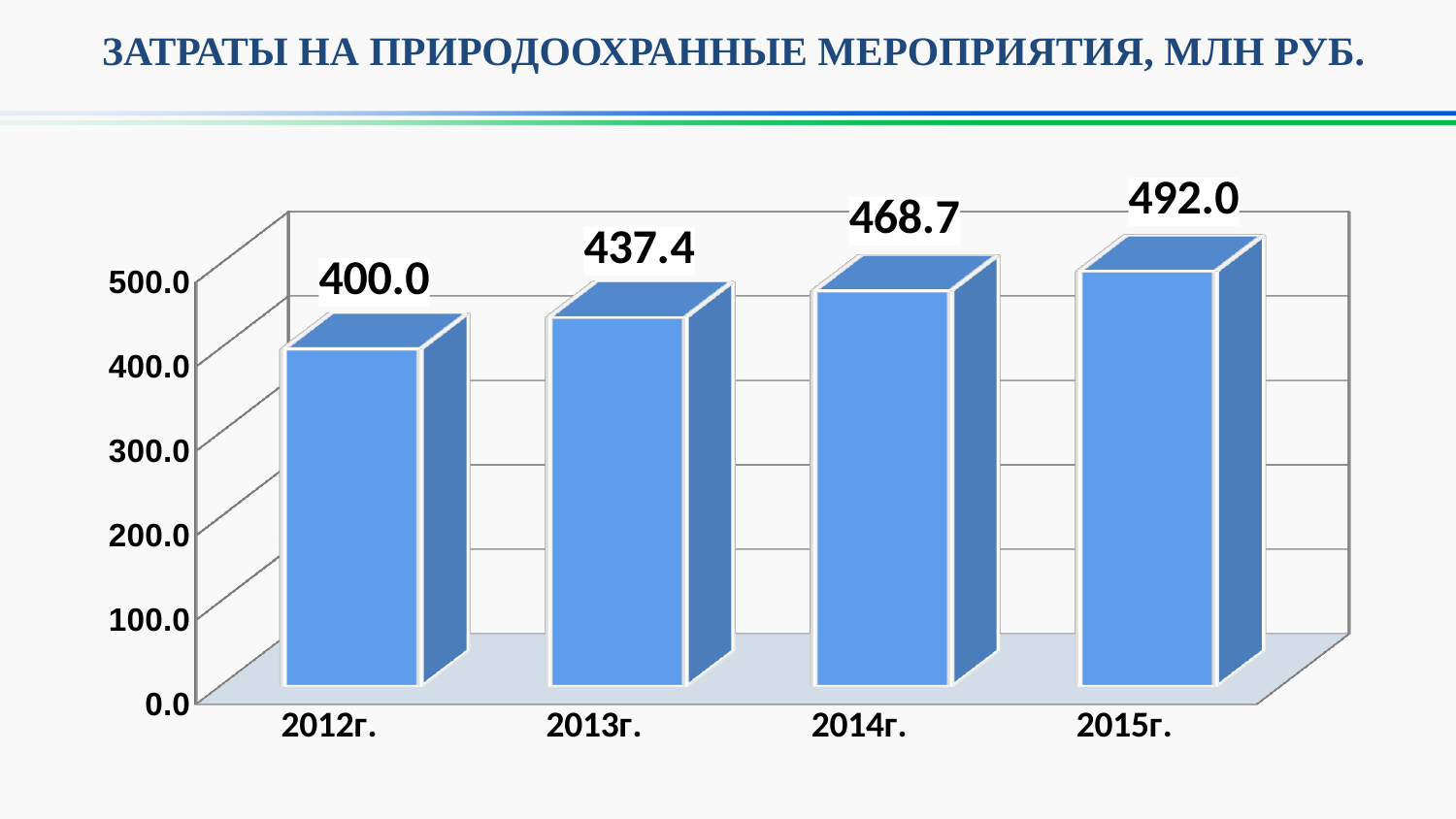
What is the value for 2015г.? 492.0 Which is larger, the value for 2013г. or the value for 2014г.? 2014г. How many years are shown on the chart? 4 What is the difference between the values for 2015г. and 2012г.? 92.0 What kind of chart is this? bar chart What is the value for 2012г.? 400.0 Do the values rise or fall from 2012г. to 2015г.? rise Which year has the lowest value? 2012г. Which year has the highest value? 2015г. What is the value for 2014г.? 468.7 What is the value for 2013г.? 437.4 What is the difference between the values for 2014г. and 2013г.? 31.3